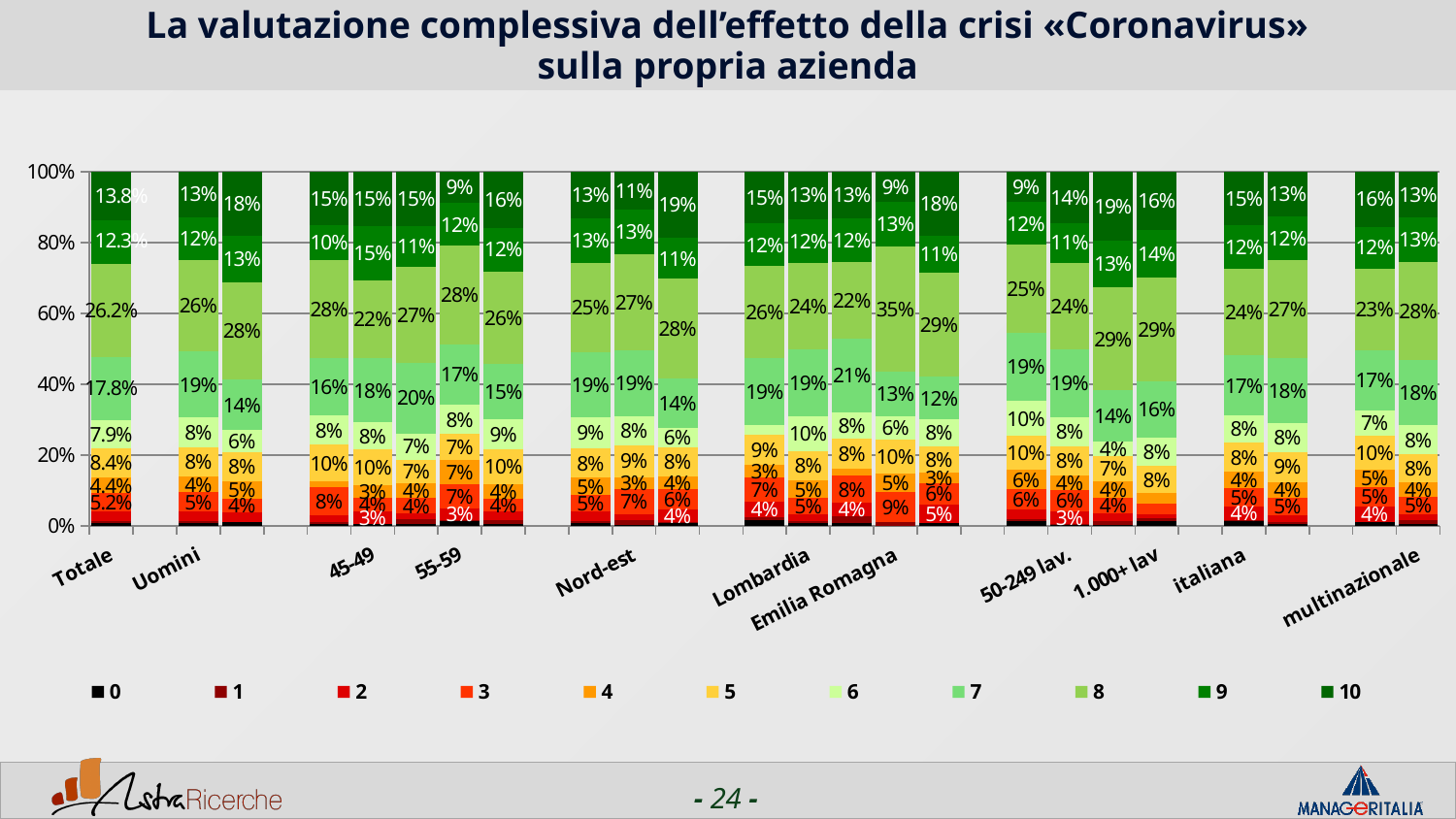
What is the title of the slide? La valutazione complessiva dell'effetto della crisi «Coronavirus» sulla propria azienda What is the value for series 8 in the Emilia Romagna bar? 35% What kind of chart is shown on the slide? Stacked bar chart How many series does the legend list? 11 In the Totale bar, which is larger: the value for series 8 or the value for series 7? Series 8 What is the value for series 10 in the Totale bar? 13.8% What is the value for series 6 in the Totale bar? 7.9% What is the value for series 8 in the Totale bar? 26.2% What is the value for series 10 in the Uomini bar? 13% In the Totale bar, what is the difference between the value for series 10 and the value for series 9? 1.5 percentage points In the Totale bar, which series has the largest share? 8 What is the value for series 7 in the Totale bar? 17.8%